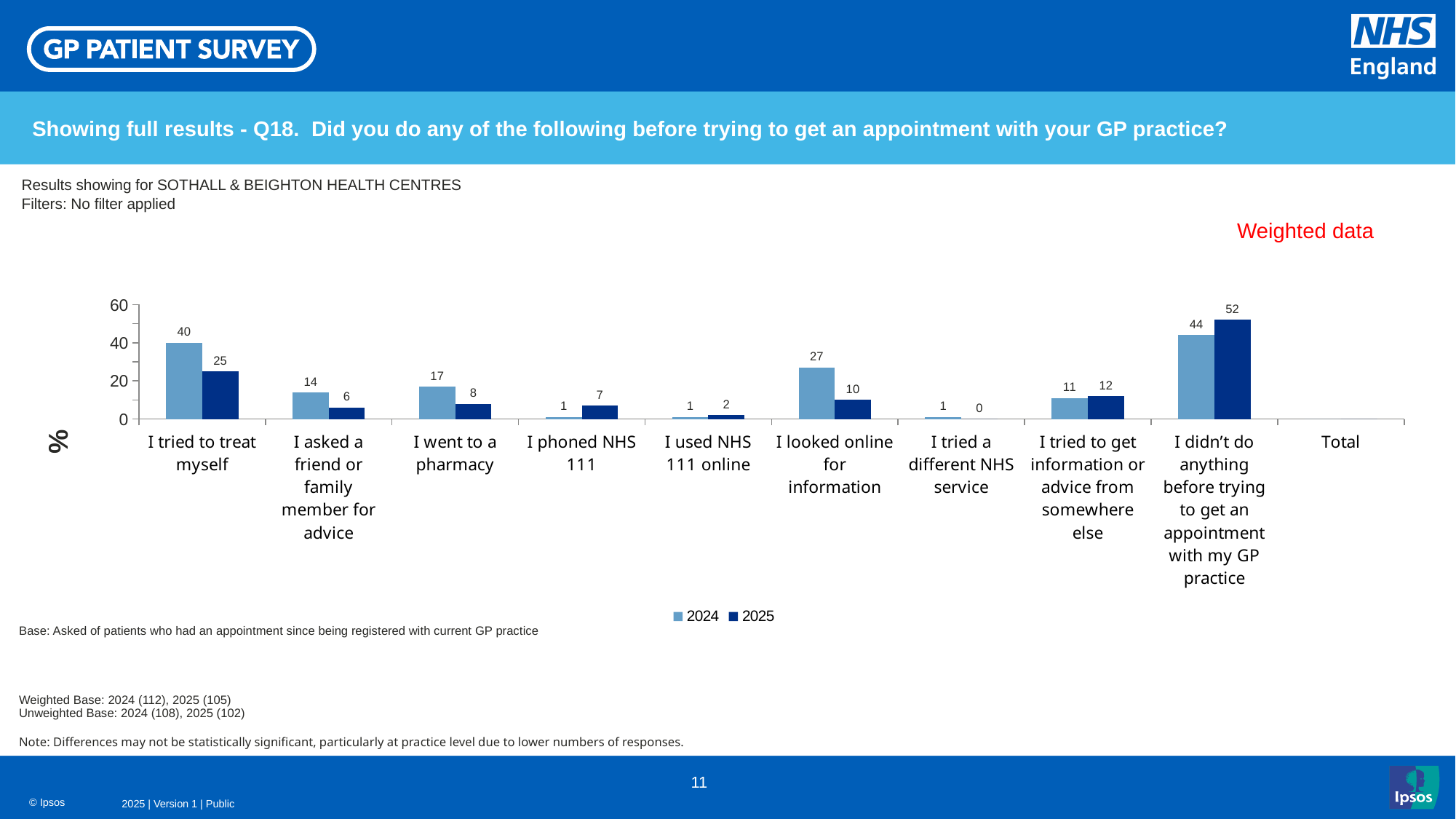
How many series does the legend list? 2 Which category has the lowest 2025 value? I tried a different NHS service What is the 2025 value for 'I didn't do anything before trying to get an appointment with my GP practice'? 52 What is the difference between the 2024 and 2025 values for 'I asked a friend or family member for advice'? 8 What is the difference between the 2024 and 2025 values for 'I tried to treat myself'? 15 Is the 2024 value for 'I looked online for information' greater or less than 20? greater What is the 2024 value for 'I tried to treat myself'? 40 Which category has the highest 2025 value? I didn't do anything before trying to get an appointment with my GP practice What is the 2024 value for 'I tried to get information or advice from somewhere else'? 11 What kind of chart is shown on the slide? Bar chart Which is larger for 'I went to a pharmacy', the 2024 value or the 2025 value? 2024 What is the 2025 value for 'I looked online for information'? 10